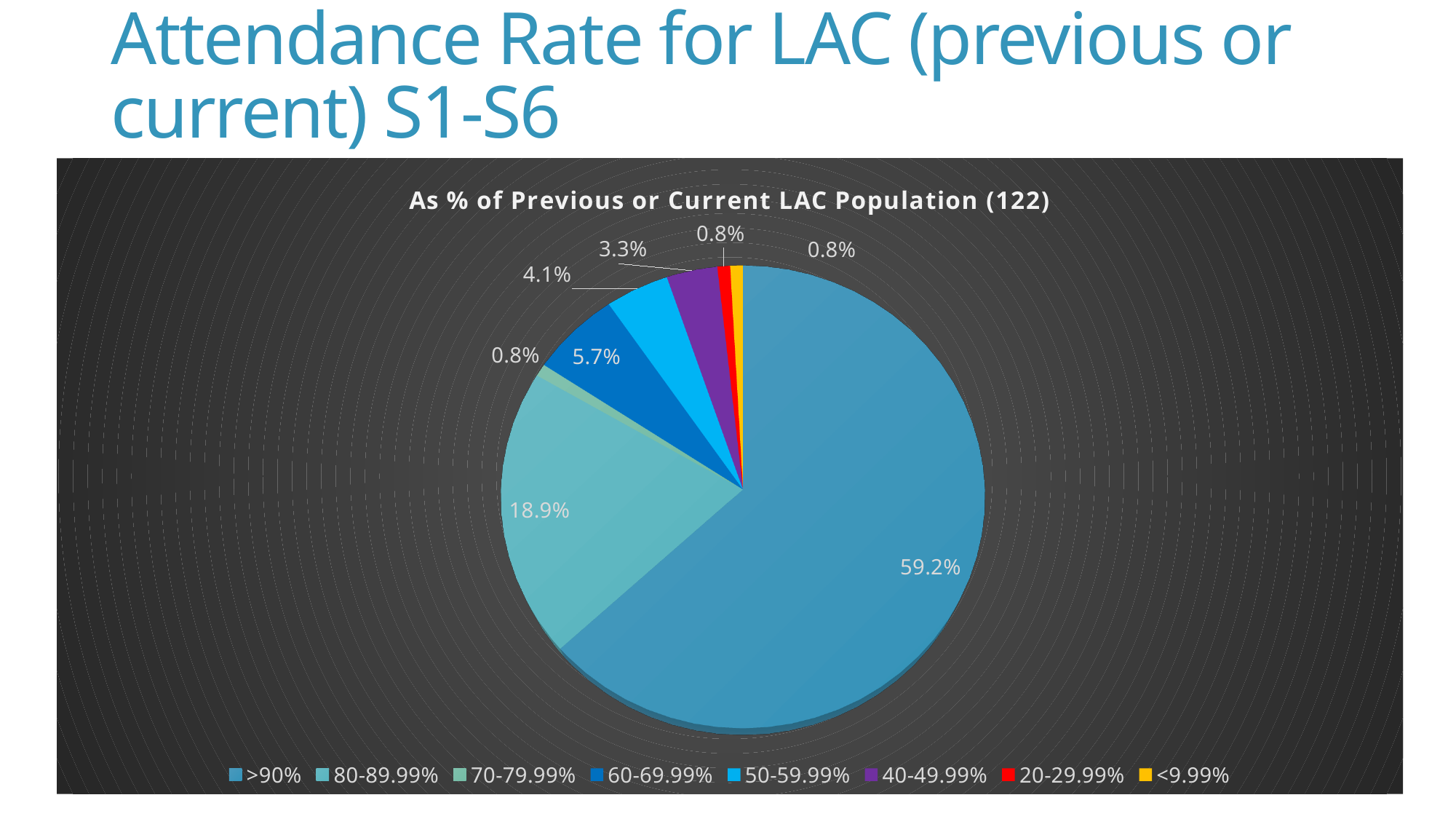
What type of chart is shown on the slide? pie chart What share of the pie is the 80-89.99% attendance category? 18.9% What is the chart's title? As % of Previous or Current LAC Population (122) What colour is the slice for the <9.99% category? yellow What share of the pie is the 60-69.99% attendance category? 5.7% Which attendance category has the largest share of the pie? >90% Which has the larger share: 60-69.99% or 50-59.99%? 60-69.99% What share of the pie is the >90% attendance category? 59.2% What is the difference between the shares of the >90% and 80-89.99% categories? 40.3% How many categories does the legend list? 8 What share of the pie is the 50-59.99% attendance category? 4.1% What share of the pie is the 40-49.99% attendance category? 3.3%